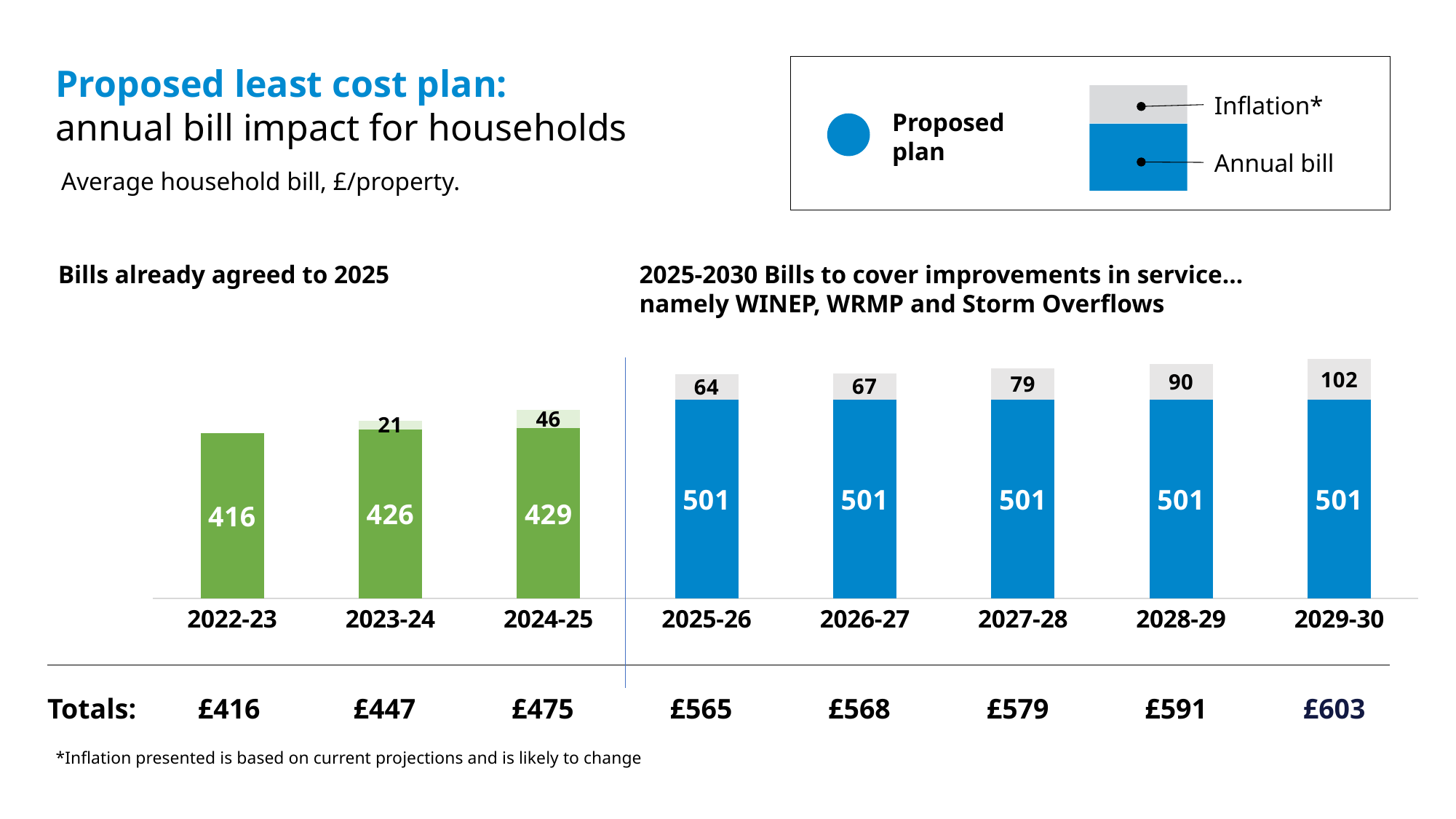
Which year has the lowest total bill? 2022-23 Which has the larger inflation value, 2023-24 or 2024-25? 2024-25 What kind of chart is shown on the slide? Stacked bar chart What is the annual bill value shown for 2024-25? 429 What is the annual bill value shown for 2025-26? 501 Do the total bills rise or fall from 2022-23 to 2029-30? Rise How much larger is the inflation value for 2029-30 than for 2025-26? 38 What is the difference between the total bill for 2029-30 and the total bill for 2022-23? £187 How many years are shown on the chart? 8 Which year has the highest total bill? 2029-30 What is the total bill shown for 2027-28? £579 What is the inflation value shown on the 2029-30 bar? 102